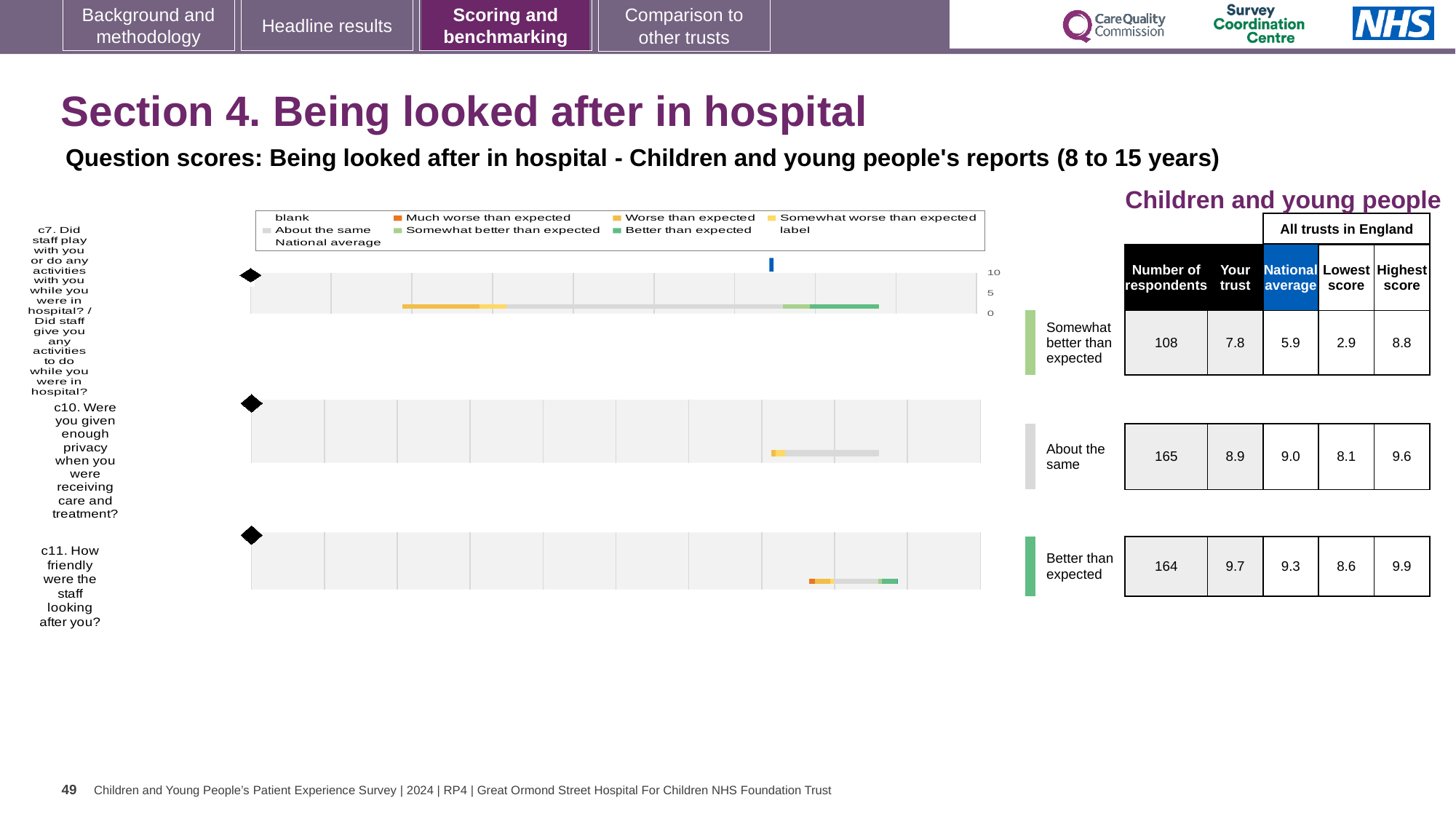
For question c7, how much higher is the trust's score than the national average? 1.9 How many survey questions are charted on this slide? 3 What is the 'Your trust' score for question c11 (How friendly were the staff looking after you?)? 9.7 Which of the three questions has the lowest national average score? c7. Did staff play with you or do any activities with you while you were in hospital? What benchmark category is shown for question c7? Somewhat better than expected Which of the three questions has the highest 'Your trust' score? c11. How friendly were the staff looking after you? How many respondents answered question c10 (Were you given enough privacy when you were receiving care and treatment?)? 165 Which question has the most respondents? c10. Were you given enough privacy when you were receiving care and treatment? For question c10, which is larger: the trust's score or the national average? National average What is the highest score across all trusts in England for question c11? 9.9 What is the lowest score across all trusts in England for question c7? 2.9 What is the national average score for question c7 (Did staff play with you or do any activities with you while you were in hospital?)? 5.9